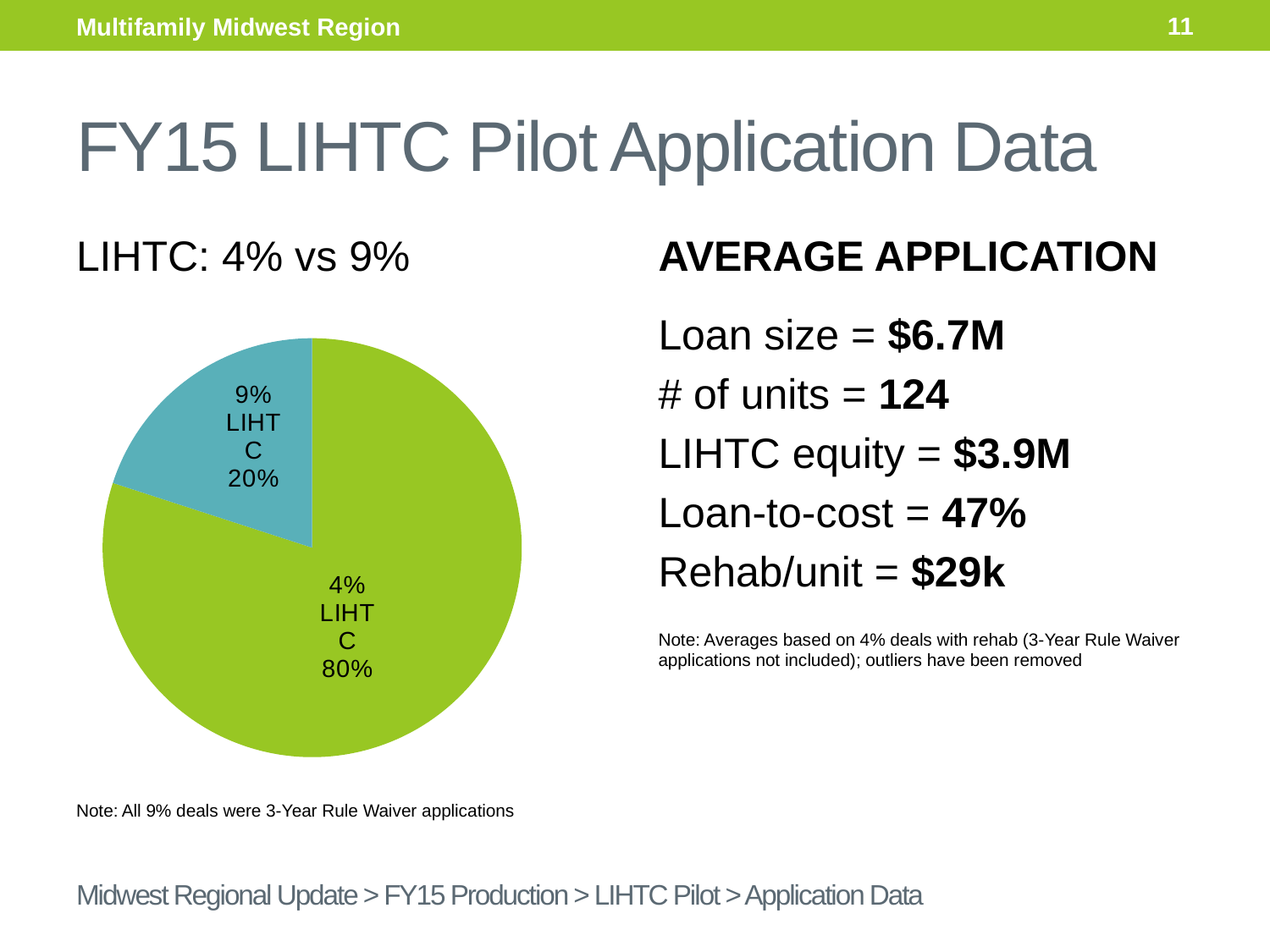
Which slice of the pie is the smallest? 9% LIHTC What is the title of the pie chart? LIHTC: 4% vs 9% What share of the pie does 9% LIHTC represent? 20% What is the difference in percentage points between the 4% LIHTC slice and the 9% LIHTC slice? 60 What colour is the 9% LIHTC slice? teal Which slice of the pie is the largest? 4% LIHTC What kind of chart is shown on the slide? pie chart Which is larger, the 4% LIHTC slice or the 9% LIHTC slice? 4% LIHTC How many slices does the pie chart have? 2 What share of the pie does 4% LIHTC represent? 80%